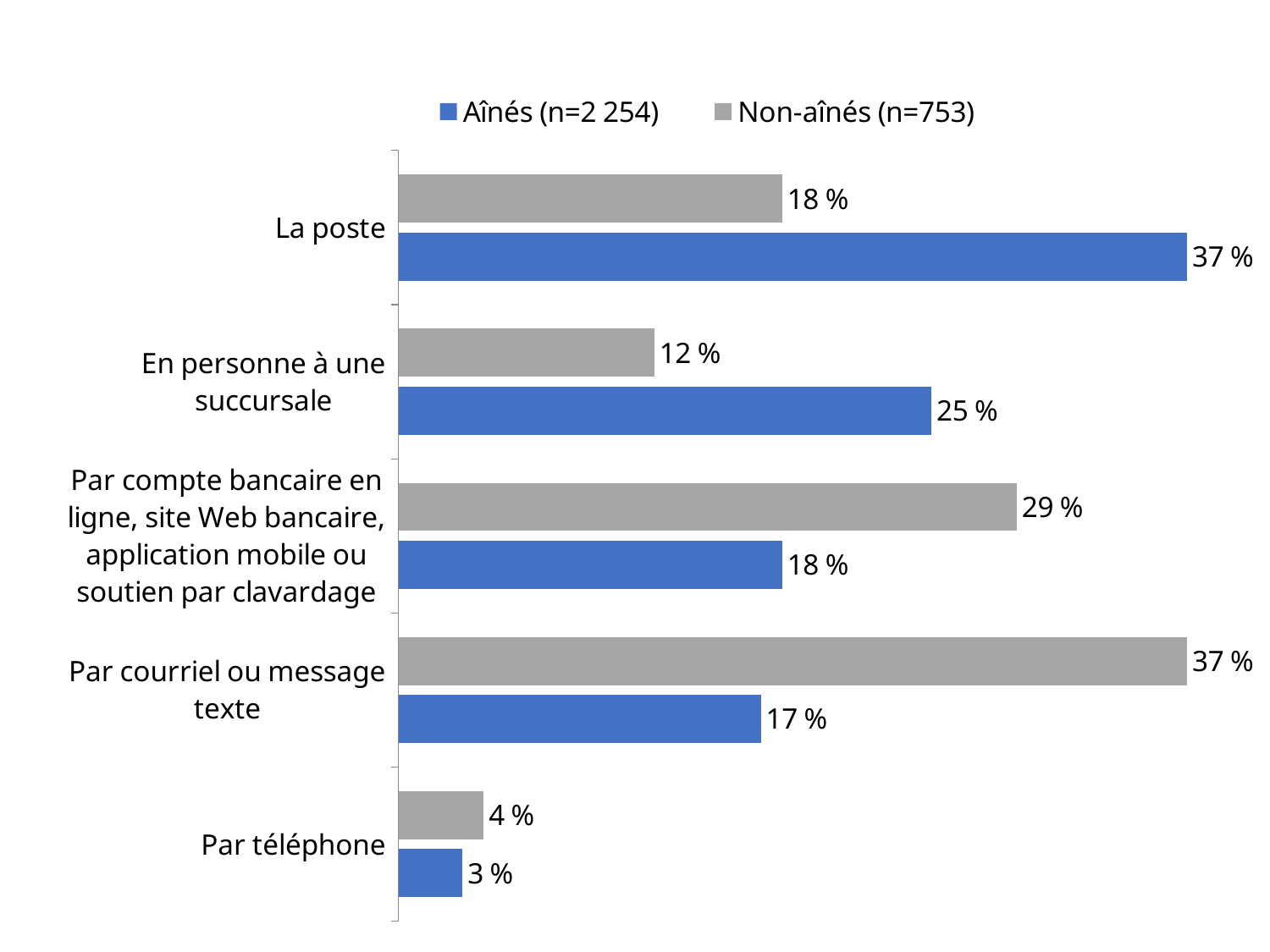
What is the value for Non-aînés (n=753) for Par téléphone? 4 % Which series has the larger value for Par compte bancaire en ligne, site Web bancaire, application mobile ou soutien par clavardage? Non-aînés (n=753) Which category has the lowest value for Non-aînés (n=753)? Par téléphone How many categories are shown on the chart? 5 How many series does the legend list? 2 What is the difference between Aînés (n=2 254) and Non-aînés (n=753) for La poste? 19 % Which category has the highest value for Aînés (n=2 254)? La poste What colour are the bars for Aînés (n=2 254)? Blue What is the value for Non-aînés (n=753) for Par courriel ou message texte? 37 % What kind of chart is shown on the slide? Bar chart What is the value for Aînés (n=2 254) for La poste? 37 % What is the value for Aînés (n=2 254) for En personne à une succursale? 25 %